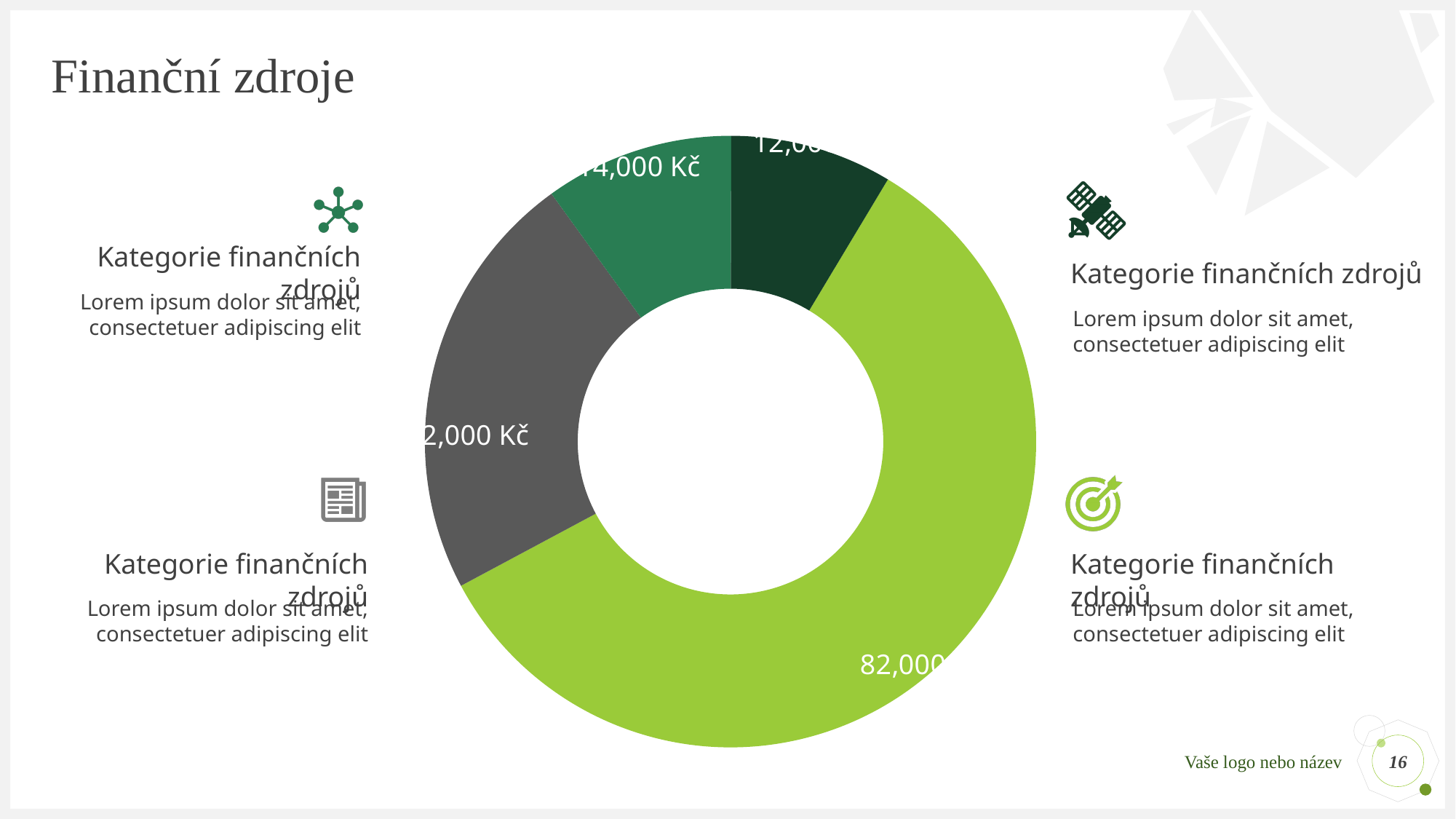
What kind of chart is shown on the slide? Donut (pie) chart Which slice is larger, the gray slice or the medium green slice? The gray slice What is the title of the slide containing the chart? Finanční zdroje Which slice of the donut chart is the smallest? The dark green slice How many slices does the donut chart have? 4 Which slice is larger, the light green slice or the gray slice? The light green slice What currency unit is shown in the chart's data labels? Kč Which slice is larger, the medium green slice or the dark green slice? The medium green slice Which slice of the donut chart is the largest? The light green slice